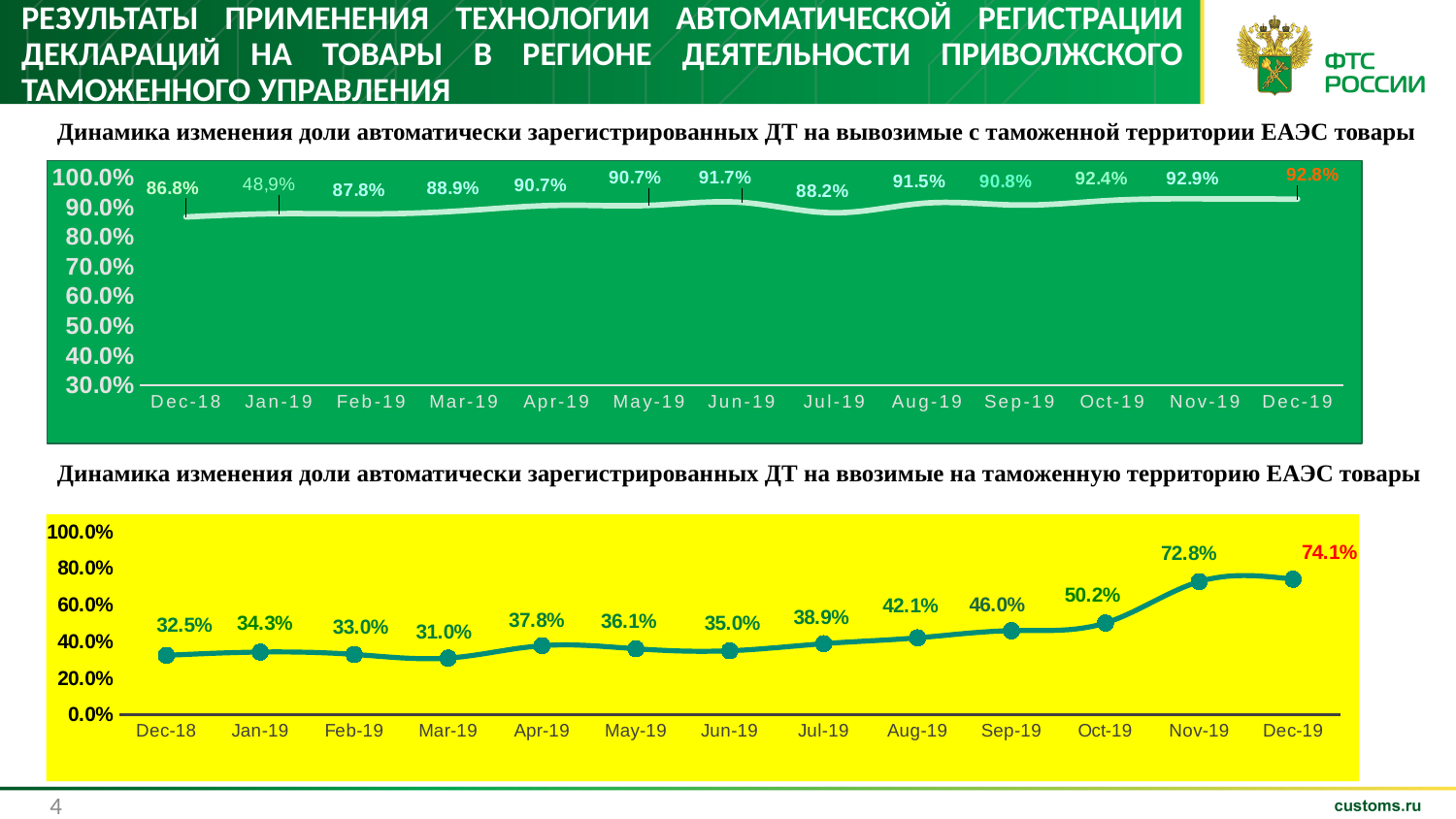
In the bottom chart (ввозимые товары), what is the value for Oct-19? 50.2% How many months are plotted on the x axis of the bottom chart (ввозимые товары)? 13 In the bottom chart (ввозимые товары), which month has the lowest value? Mar-19 In the bottom chart (ввозимые товары), what is the difference between the Dec-19 and Dec-18 values? 41.6% In the bottom chart (ввозимые товары), do the values generally rise or fall from Dec-18 to Dec-19? rise In the bottom chart (ввозимые товары), which month has the highest value? Dec-19 In the top chart (вывозимые товары), which is larger, the value for Aug-19 or the value for Jul-19? Aug-19 In the bottom chart (ввозимые товары), what is the value for Dec-19? 74.1% In the top chart (вывозимые товары), what is the value for Jun-19? 91.7% What kind of chart is the top chart (вывозимые товары)? line chart In the bottom chart (ввозимые товары), is the value for Nov-19 greater or less than 60.0%? greater In the top chart (вывозимые товары), what is the value for Jul-19? 88.2%